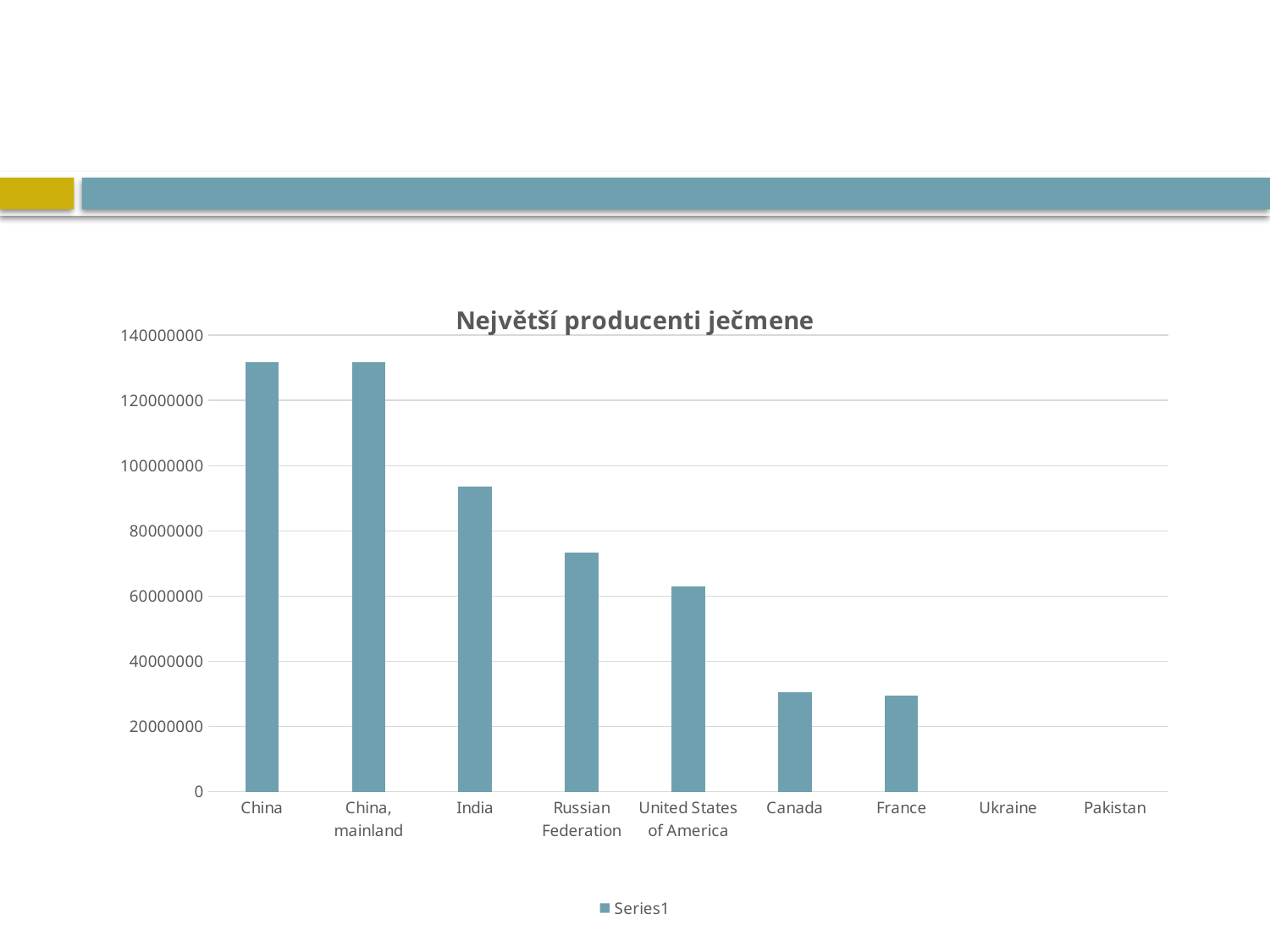
How many series does the legend list? 1 Is the value for Canada greater or less than 40000000? less Is the value for India greater or less than 80000000? greater Which has a larger value, India or Russian Federation? India Is the value for Russian Federation greater or less than 80000000? less What is the title of the chart? Největší producenti ječmene What kind of chart is shown on the slide? bar chart What is the name of the series shown in the legend? Series1 How many categories are shown on the x axis of the chart? 9 Do the values generally rise or fall moving from left to right along the x axis? fall